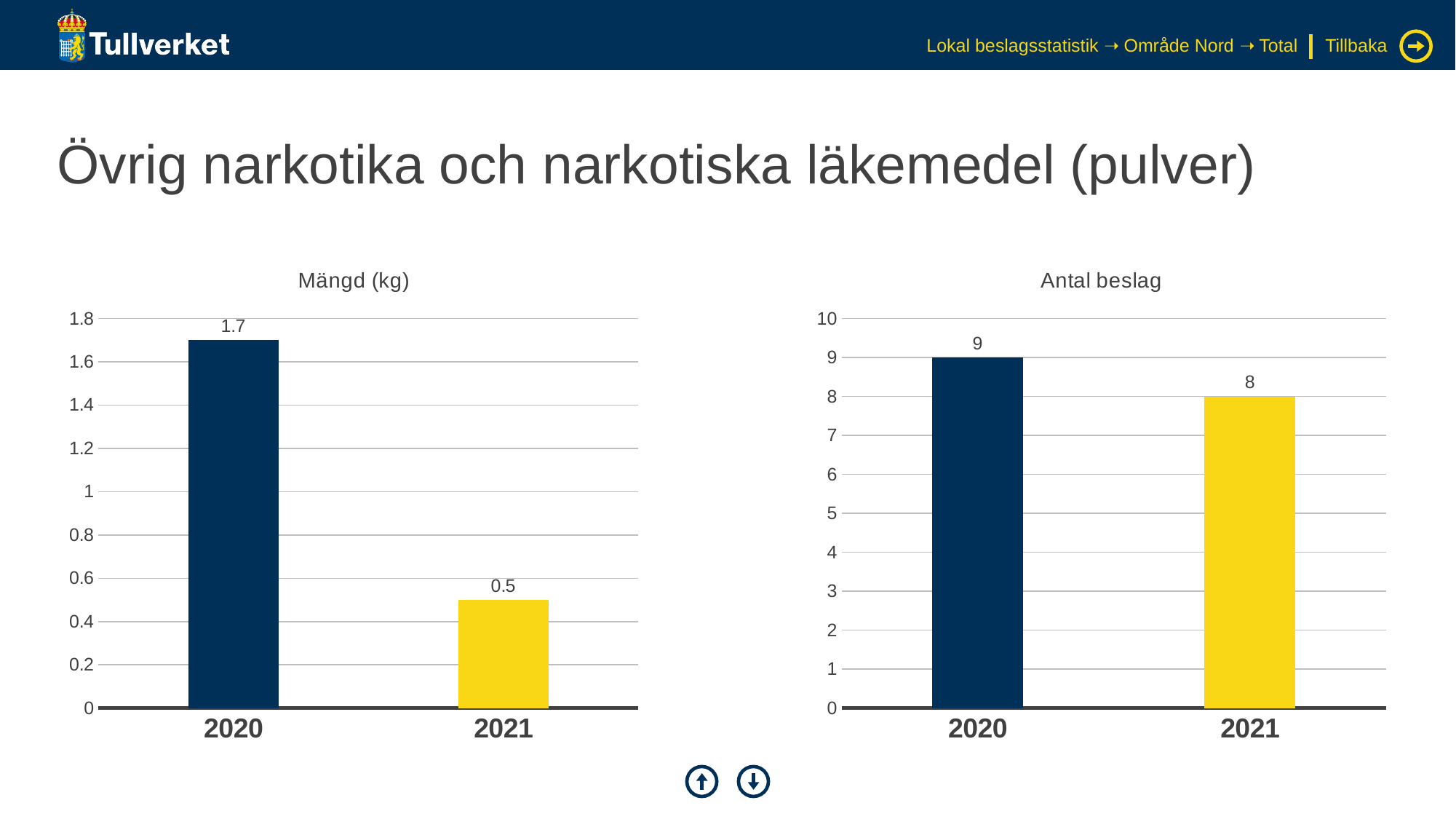
In the 'Antal beslag' chart, which is larger, the value for 2020 or 2021? 2020 In the 'Mängd (kg)' chart, what is the difference between the 2020 and 2021 values? 1.2 In the 'Mängd (kg)' chart, what is the value for 2021? 0.5 In the 'Mängd (kg)' chart, which year has the highest value? 2020 In the 'Mängd (kg)' chart, what is the value for 2020? 1.7 How many categories does the 'Antal beslag' chart show? 2 In the 'Antal beslag' chart, what is the difference between the 2020 and 2021 values? 1 What kind of chart is the 'Mängd (kg)' chart? bar chart In the 'Mängd (kg)' chart, is the value for 2021 greater or less than 1? less In the 'Antal beslag' chart, which year has the lowest value? 2021 In the 'Antal beslag' chart, what is the value for 2020? 9 In the 'Antal beslag' chart, what is the value for 2021? 8